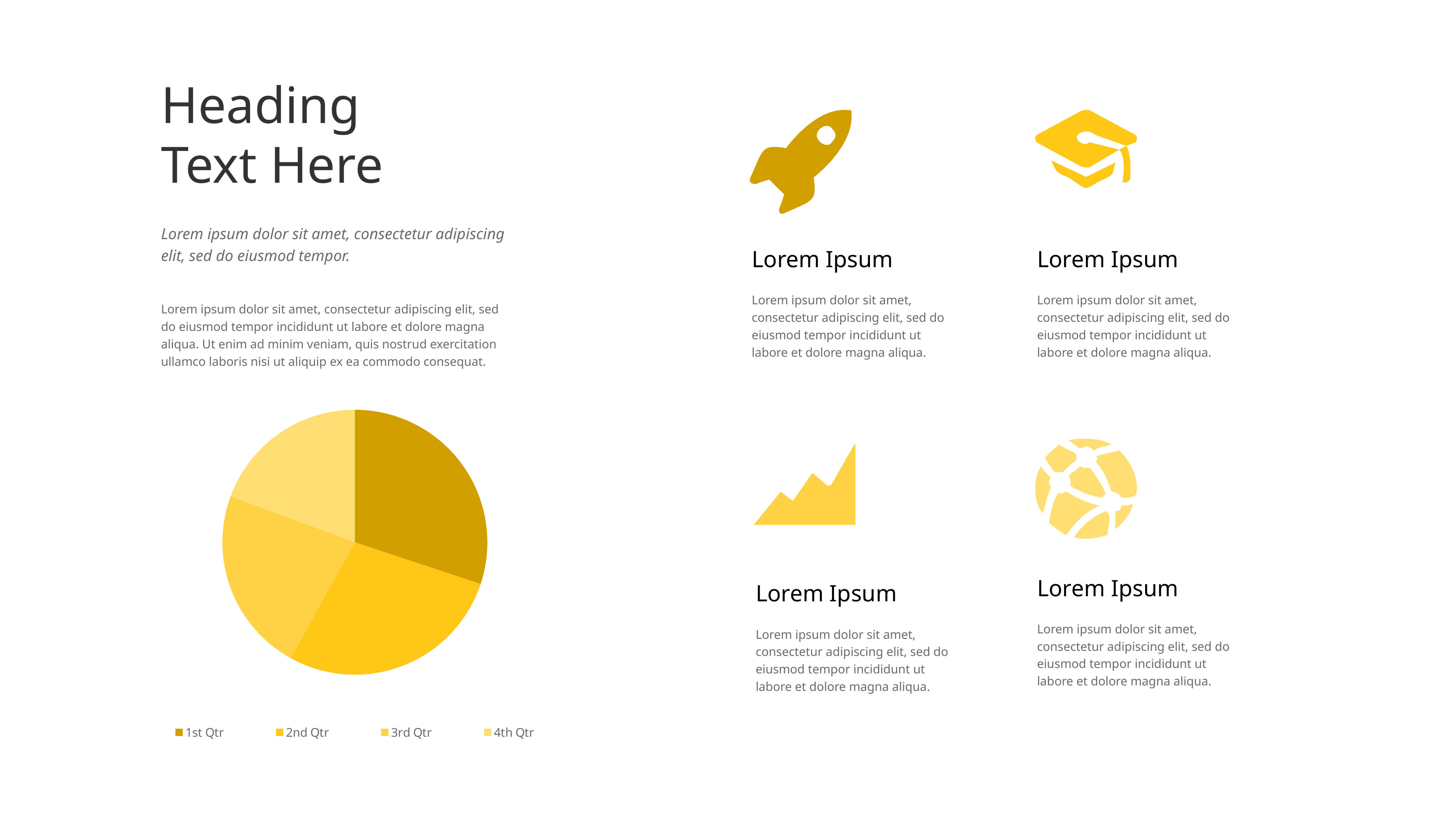
Which slice is larger in the pie chart, 1st Qtr or 4th Qtr? 1st Qtr Which legend entry of the pie chart is shown in the darkest gold colour? 1st Qtr Which slice is larger in the pie chart, 2nd Qtr or 4th Qtr? 2nd Qtr What kind of chart is shown on the slide? pie chart How many entries does the pie chart's legend list? 4 What are the legend entries of the pie chart? 1st Qtr, 2nd Qtr, 3rd Qtr, 4th Qtr How many slices does the pie chart have? 4 Which slice is larger in the pie chart, 1st Qtr or 3rd Qtr? 1st Qtr